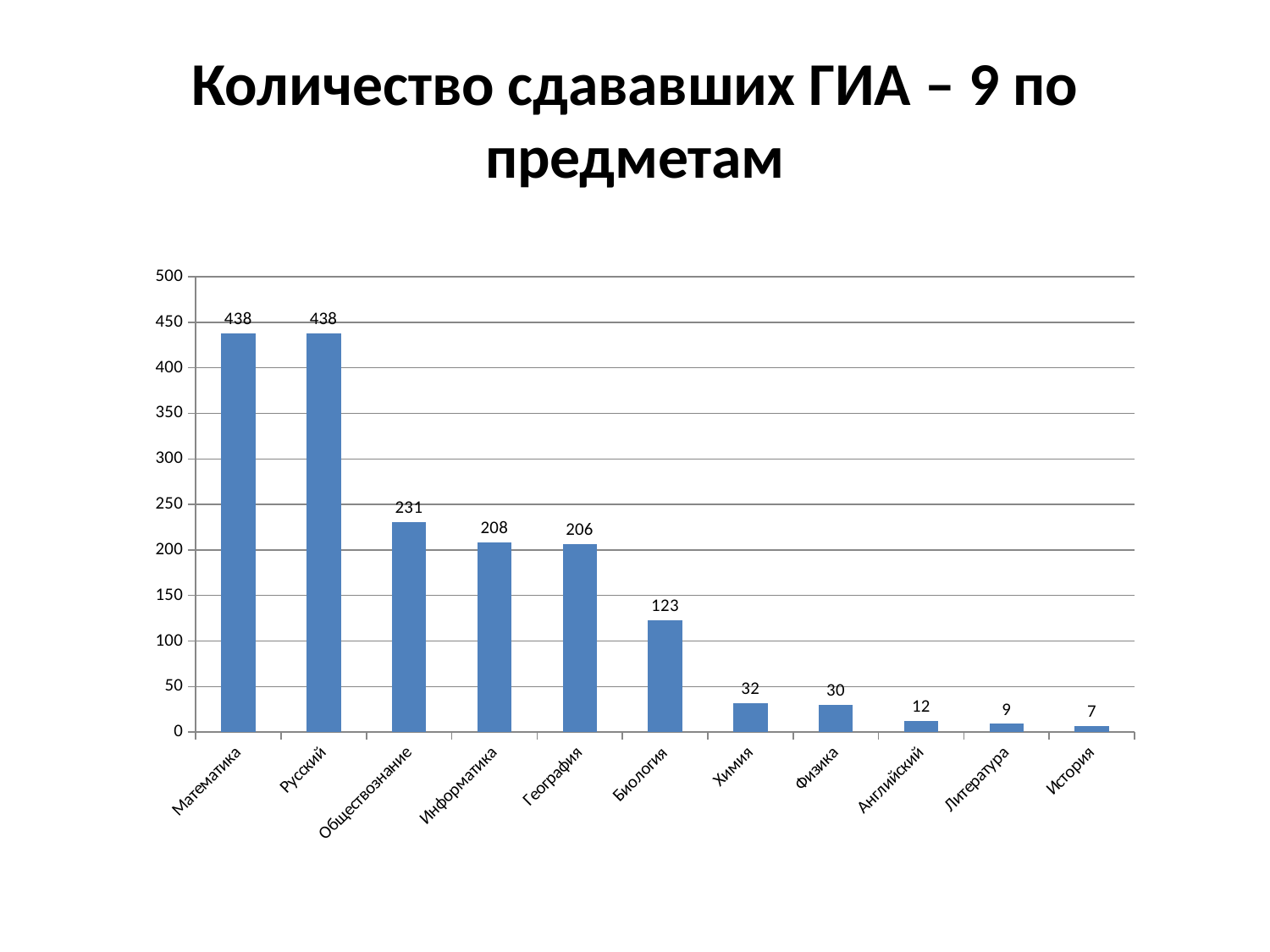
Which is larger, the value for Химия or the value for Физика? Химия What is the value for Английский? 12 What is the difference between the values for Информатика and География? 2 Which category has the lowest value? История What kind of chart is shown on the slide? bar chart What is the difference between the values for Математика and Обществознание? 207 What is the value for Биология? 123 What is the title of the slide? Количество сдававших ГИА – 9 по предметам What is the value for Обществознание? 231 Is the value for Биология greater or less than 100? greater Do the values rise or fall from left to right along the x axis? fall How many categories are shown on the x axis? 11